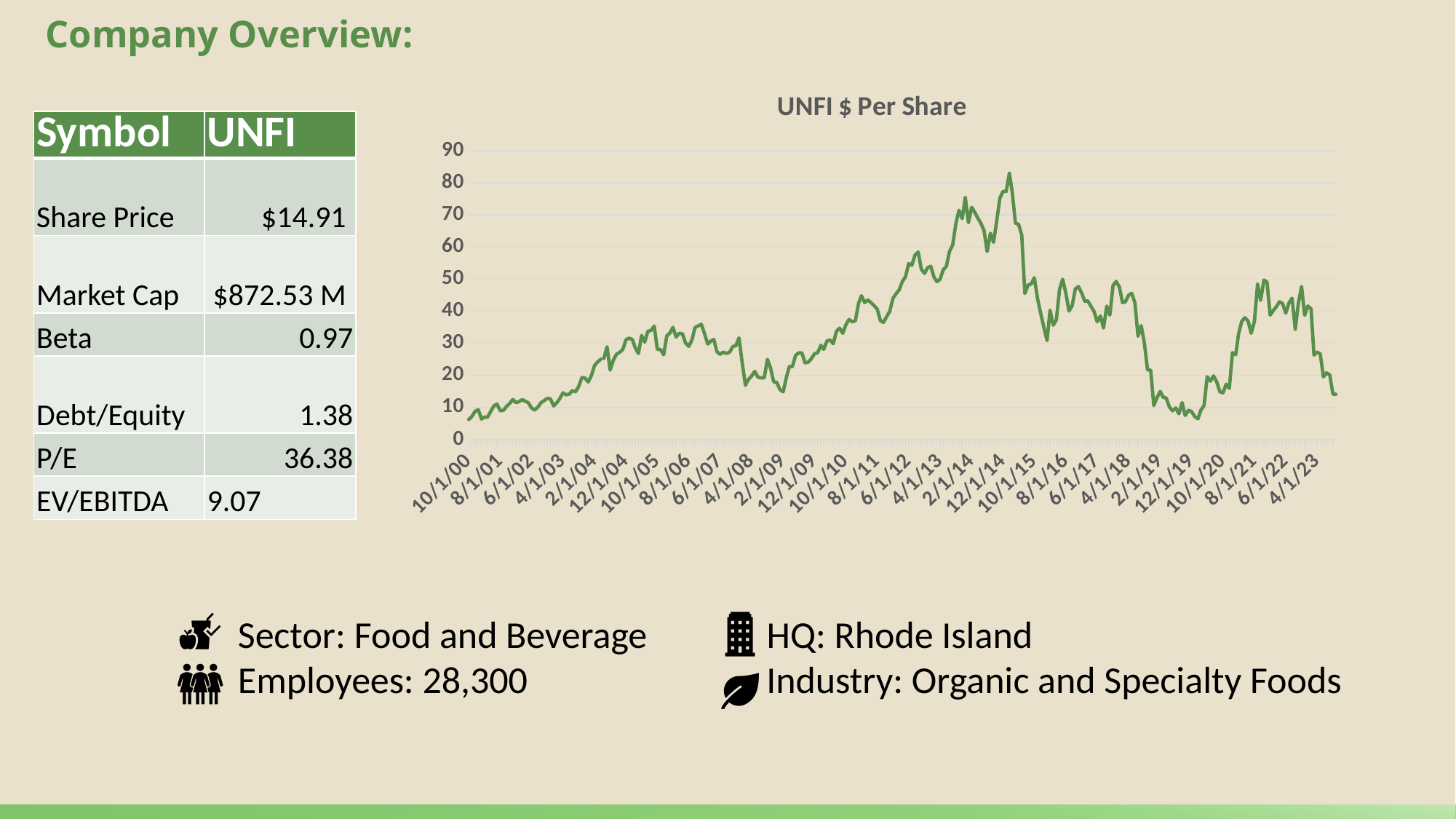
How many lines are plotted on the UNFI $ Per Share chart? 1 Is the value around 2/1/14 larger or smaller than the value around 4/1/23? larger Is the value around 4/1/13 greater or less than 40? greater Between 10/1/00 and 2/1/14, does the line generally rise or fall? rise What kind of chart is shown on the slide? line chart Is the value around 10/1/19 greater or less than 10? less Is the highest point of the line greater or less than 80? greater What is the title of the chart? UNFI $ Per Share What is the highest value shown on the vertical axis of the chart? 90 Between 12/1/14 and 2/1/19, does the line generally rise or fall? fall